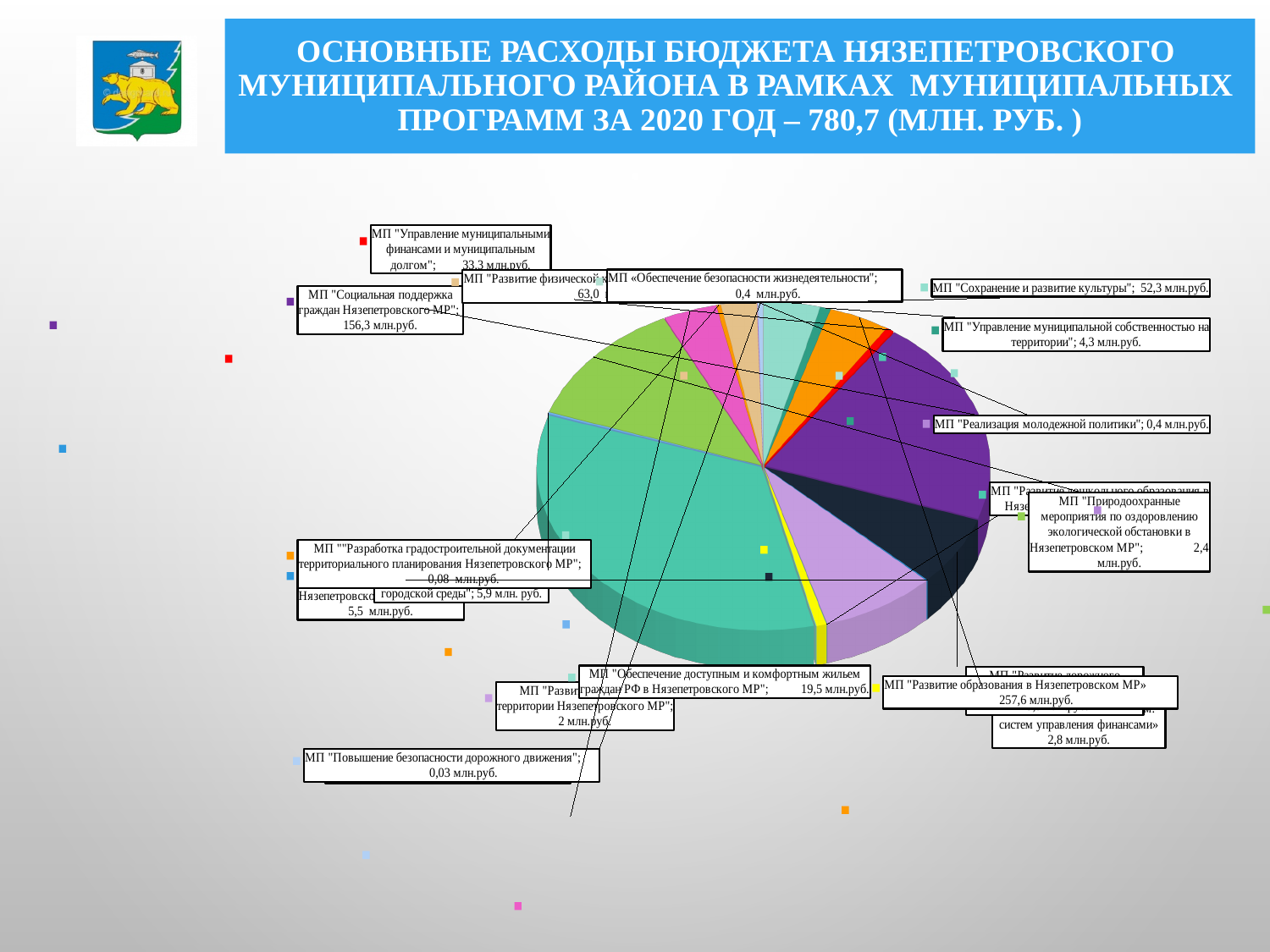
Which is larger: the value for МП "Сохранение и развитие культуры" or МП "Управление муниципальными финансами и муниципальным долгом"? МП "Сохранение и развитие культуры" What is the value for МП "Социальная поддержка граждан Нязепетровского МР"? 156,3 млн.руб. What is the value for МП "Управление муниципальными финансами и муниципальным долгом"? 33,3 млн.руб. Which labelled program has the smallest value? МП "Повышение безопасности дорожного движения" What is the value for МП "Сохранение и развитие культуры"? 52,3 млн.руб. What is the value for МП "Обеспечение доступным и комфортным жильем граждан РФ в Нязепетровского МР"? 19,5 млн.руб. What is the value for МП "Повышение безопасности дорожного движения"? 0,03 млн.руб. What is the difference between the values for МП "Развитие образования в Нязепетровском МР" and МП "Социальная поддержка граждан Нязепетровского МР"? 101,3 млн.руб. What kind of chart is shown on the slide? pie chart According to the slide title, what is the total of the main budget expenditures under municipal programs for 2020? 780,7 млн. руб. Which program has the largest share of the pie? МП "Развитие образования в Нязепетровском МР" What is the value for МП "Развитие образования в Нязепетровском МР"? 257,6 млн.руб.